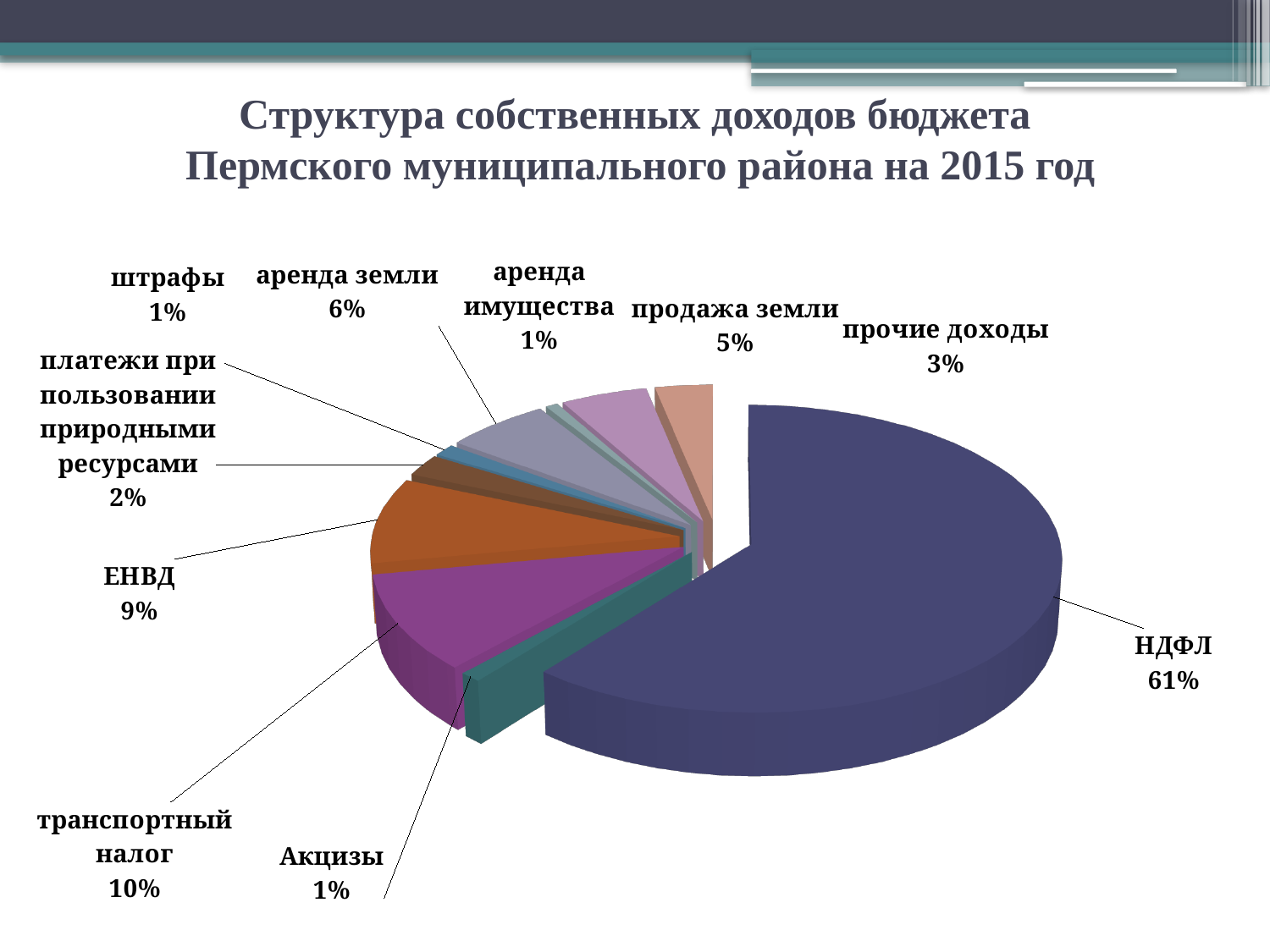
What is the value shown for аренда земли? 6% What is the value shown for транспортный налог? 10% Which is larger, the share of аренда земли or the share of продажа земли? аренда земли What share of the pie does НДФЛ account for? 61% What kind of chart is shown on the slide? pie chart What is the difference between the shares of транспортный налог and ЕНВД? 1% What is the value shown for ЕНВД? 9% Which category has the largest share of the pie? НДФЛ What is the value shown for продажа земли? 5% What is the value shown for платежи при пользовании природными ресурсами? 2% What is the title of the chart on the slide? Структура собственных доходов бюджета Пермского муниципального района на 2015 год How many categories are shown in the pie chart? 10